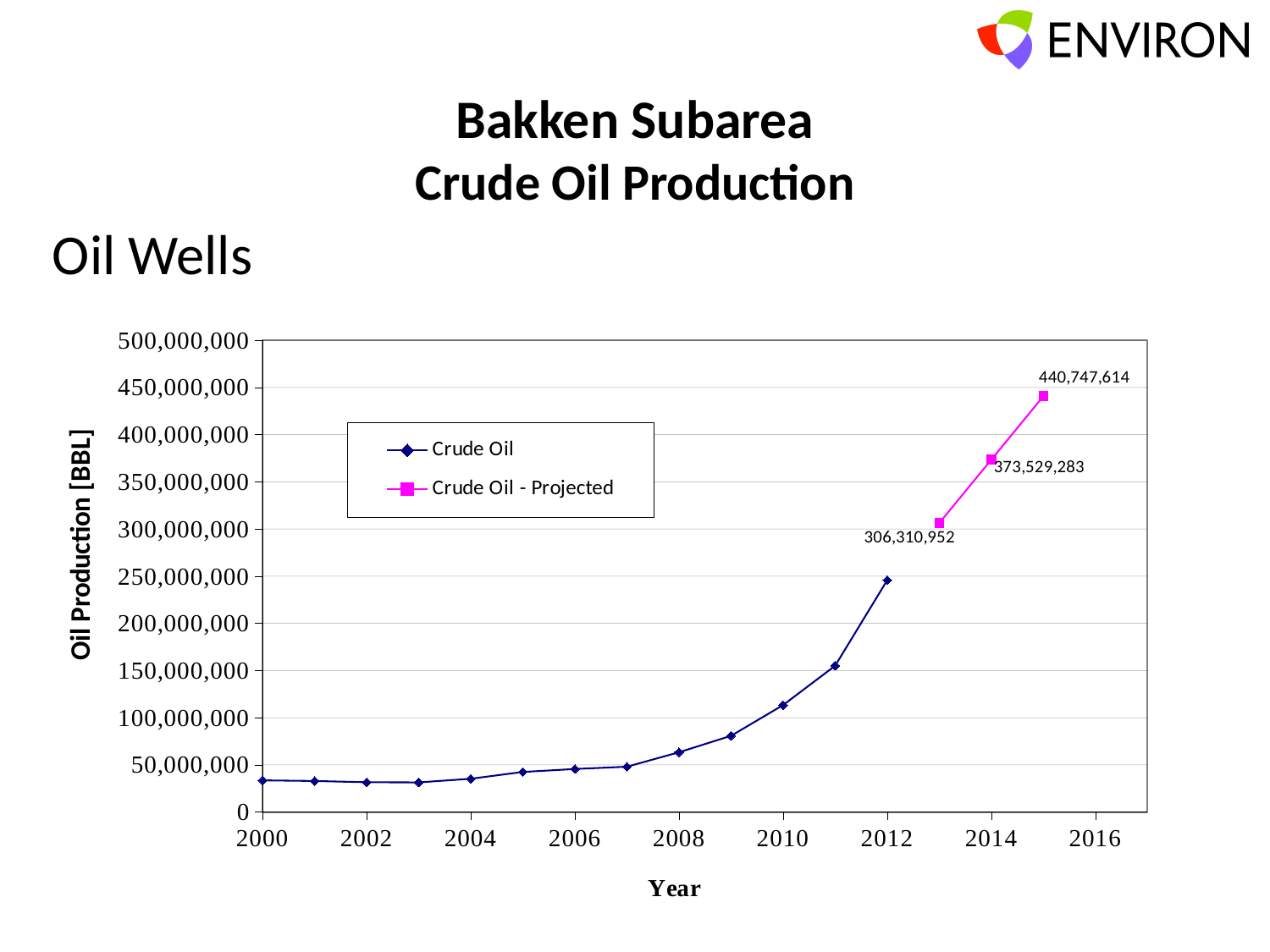
Is the Crude Oil value for 2012 greater or less than 200,000,000? greater Is the Crude Oil value for 2008 greater or less than 100,000,000? less What kind of chart is shown on the slide? Line chart What is the projected crude oil production value shown for 2014? 373,529,283 How many series does the legend list? 2 What is the difference between the projected values for 2014 and 2013? 67,218,331 What is the difference between the projected values for 2015 and 2013? 134,436,662 What is the projected crude oil production value shown for 2015? 440,747,614 What is the projected crude oil production value shown for 2013? 306,310,952 Does the Crude Oil series rise or fall between 2007 and 2012? Rise Which year has the highest value in the Crude Oil - Projected series? 2015 What is the title of the vertical axis? Oil Production [BBL]